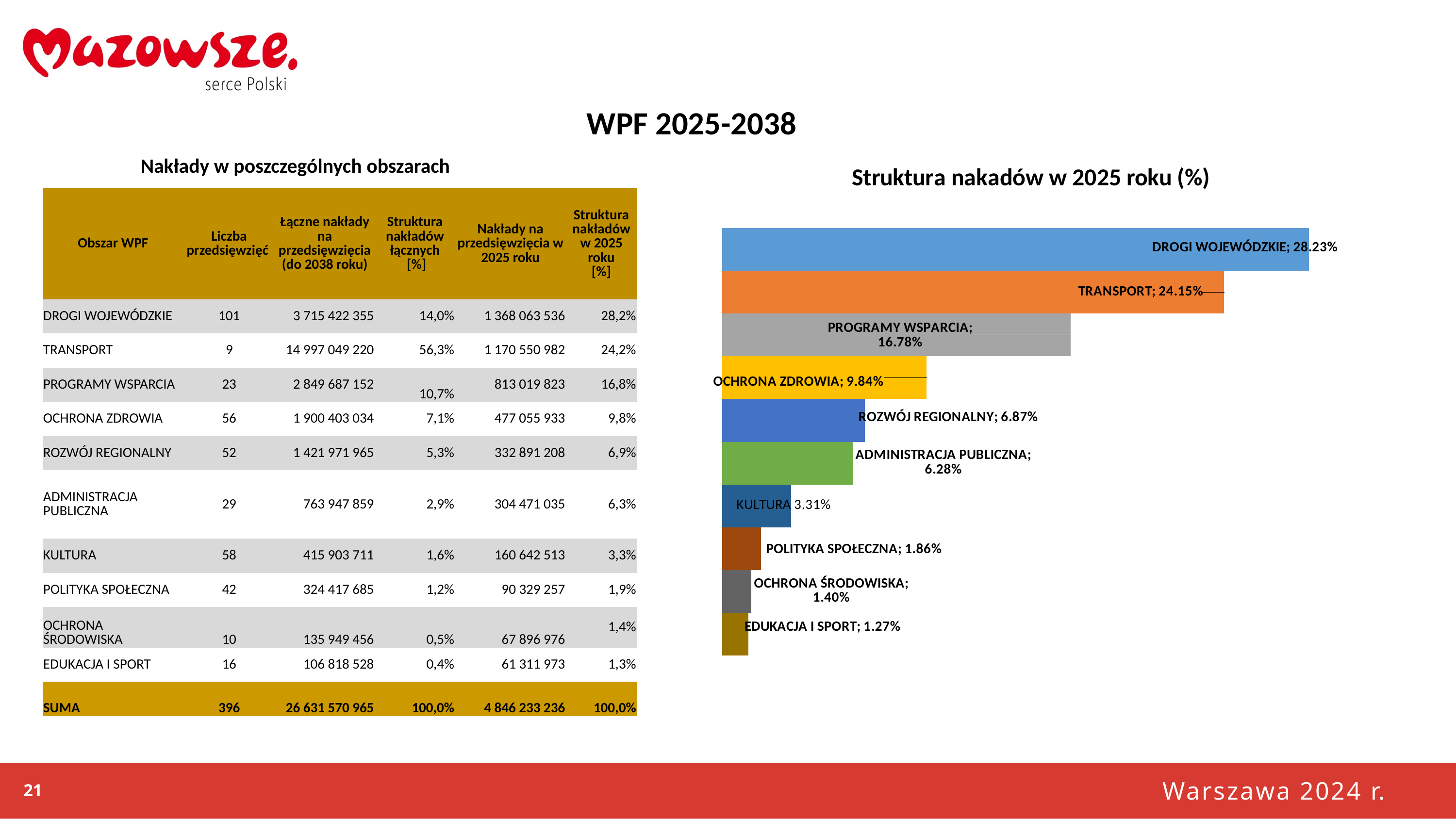
What is the value for OCHRONA ŚRODOWISKA in the chart? 1.40% What is the title of the chart on the slide? Struktura nakadów w 2025 roku (%) How many categories are plotted in the chart? 10 Which category has the lowest value in the chart? EDUKACJA I SPORT What is the difference between the values for DROGI WOJEWÓDZKIE and TRANSPORT? 4.08% What kind of chart is shown on the slide? bar chart What is the value for DROGI WOJEWÓDZKIE in the chart? 28.23% Which is larger in the chart, ROZWÓJ REGIONALNY or ADMINISTRACJA PUBLICZNA? ROZWÓJ REGIONALNY What is the value for KULTURA in the chart? 3.31% What is the value for PROGRAMY WSPARCIA in the chart? 16.78% Which category has the highest value in the chart? DROGI WOJEWÓDZKIE Do the bar values rise or fall going from the top of the chart to the bottom? fall